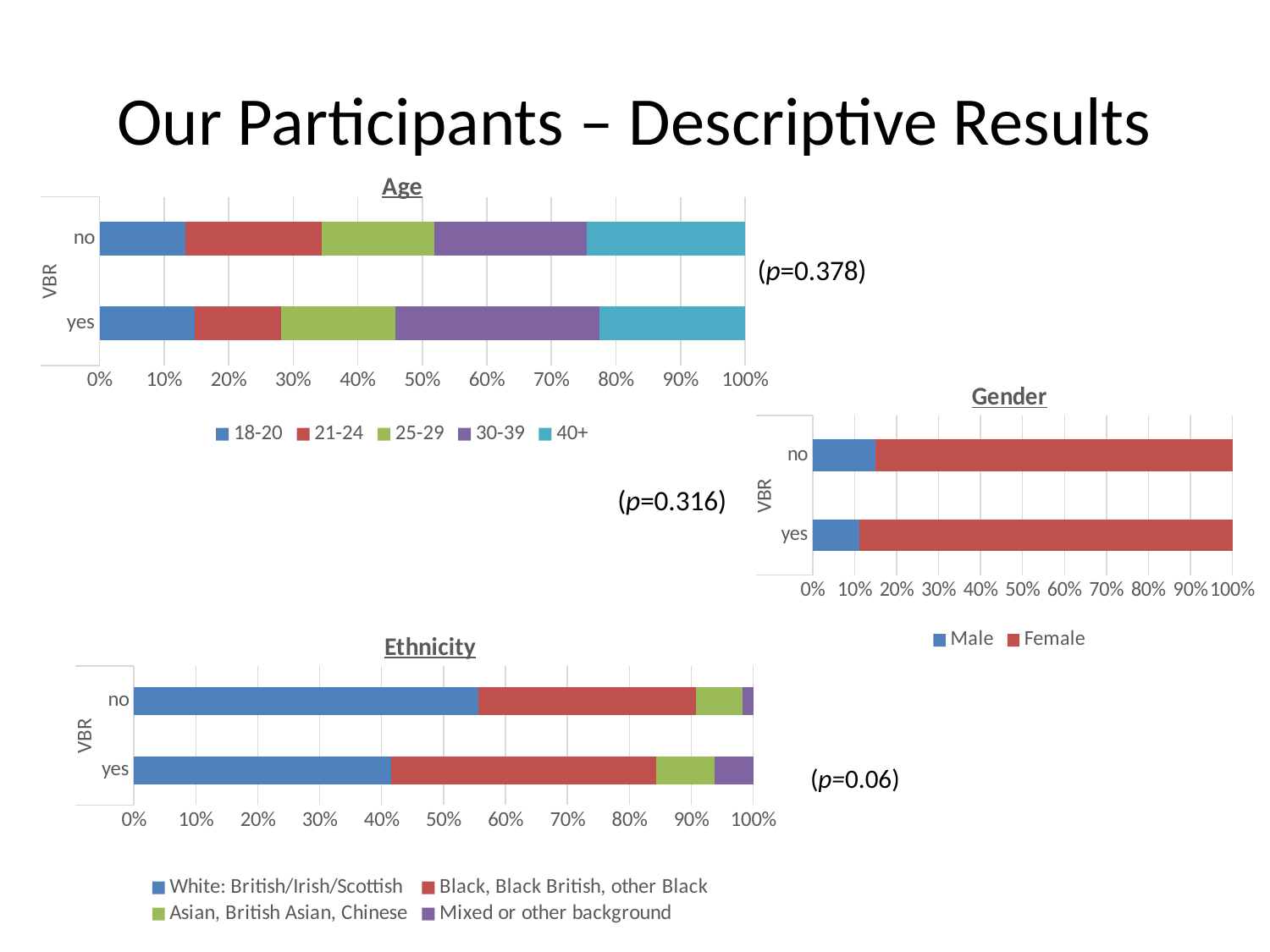
How many series does the legend of the Gender chart list? 2 In the Age chart, is the 18-20 share for the 'no' group greater or less than 20%? less In the Ethnicity chart, is the 'White: British/Irish/Scottish' share for the 'yes' group greater or less than 50%? less In the Ethnicity chart, is the 'White: British/Irish/Scottish' share for the 'no' group greater or less than 50%? greater What kind of chart is the Age chart? bar chart How many series does the legend of the Age chart list? 5 In the Ethnicity chart, which group has the larger 'White: British/Irish/Scottish' share, 'no' or 'yes'? no How many series does the legend of the Ethnicity chart list? 4 In the Gender chart, which series has the larger share for the 'yes' group, Male or Female? Female What p-value is shown next to the Ethnicity chart? p=0.06 How many VBR categories are plotted on the Ethnicity chart? 2